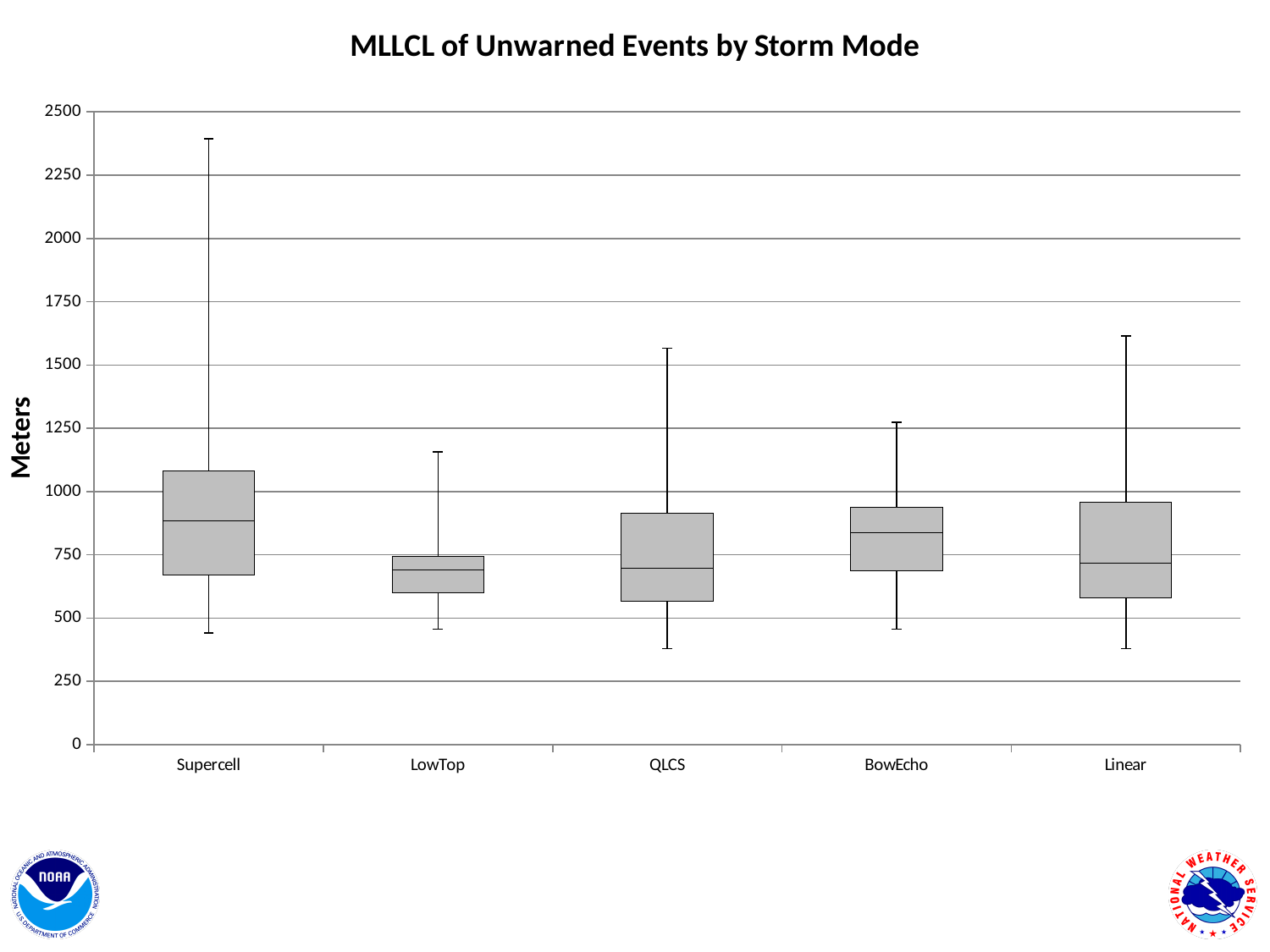
Is the median line for LowTop greater or less than 750? less Is the upper whisker for QLCS greater or less than 1500? greater Which storm mode has the narrowest box (smallest interquartile range)? LowTop How many storm mode categories are shown on the x axis? 5 Is the lower whisker for Supercell greater or less than 500? less What kind of chart is shown on the slide? Box plot (box-and-whisker chart) Which has the higher upper whisker, Linear or BowEcho? Linear Which storm mode has the highest upper whisker? Supercell What is the title of the chart? MLLCL of Unwarned Events by Storm Mode Which has the higher median, Supercell or LowTop? Supercell